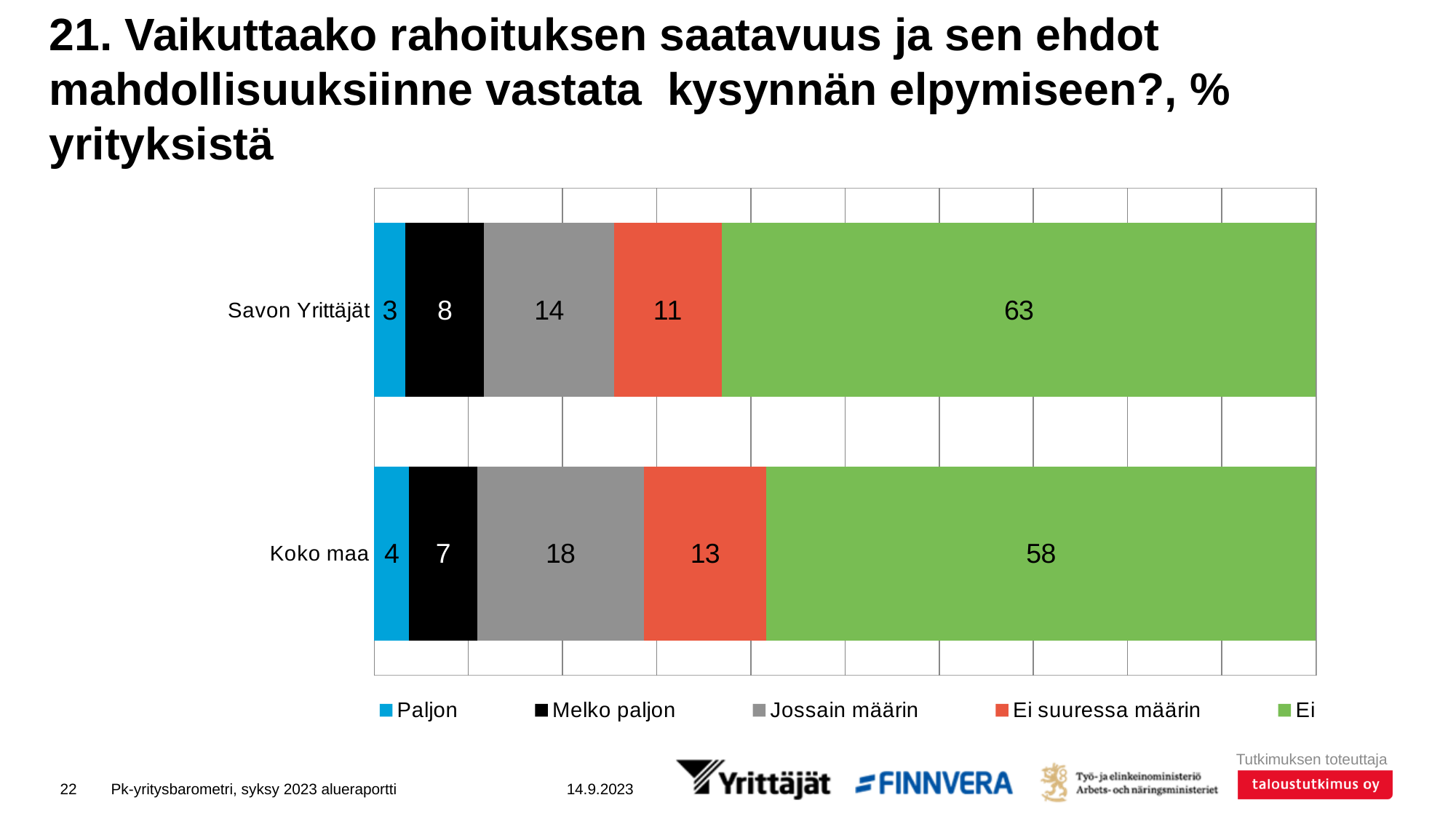
What is the value for "Ei" for Savon Yrittäjät? 63 What is the value for "Paljon" for Savon Yrittäjät? 3 How many categories are shown on the y axis? 2 Which has the larger "Melko paljon" value, Savon Yrittäjät or Koko maa? Savon Yrittäjät Which series has the lowest value for Savon Yrittäjät? Paljon What is the difference between the "Ei" values for Savon Yrittäjät and Koko maa? 5 Which series has the highest value for Koko maa? Ei What is the value for "Jossain määrin" for Koko maa? 18 What is the total of the stacked bar for Savon Yrittäjät? 99 What is the value for "Ei suuressa määrin" for Koko maa? 13 What kind of chart is shown on the slide? Stacked bar chart How many series does the legend list? 5